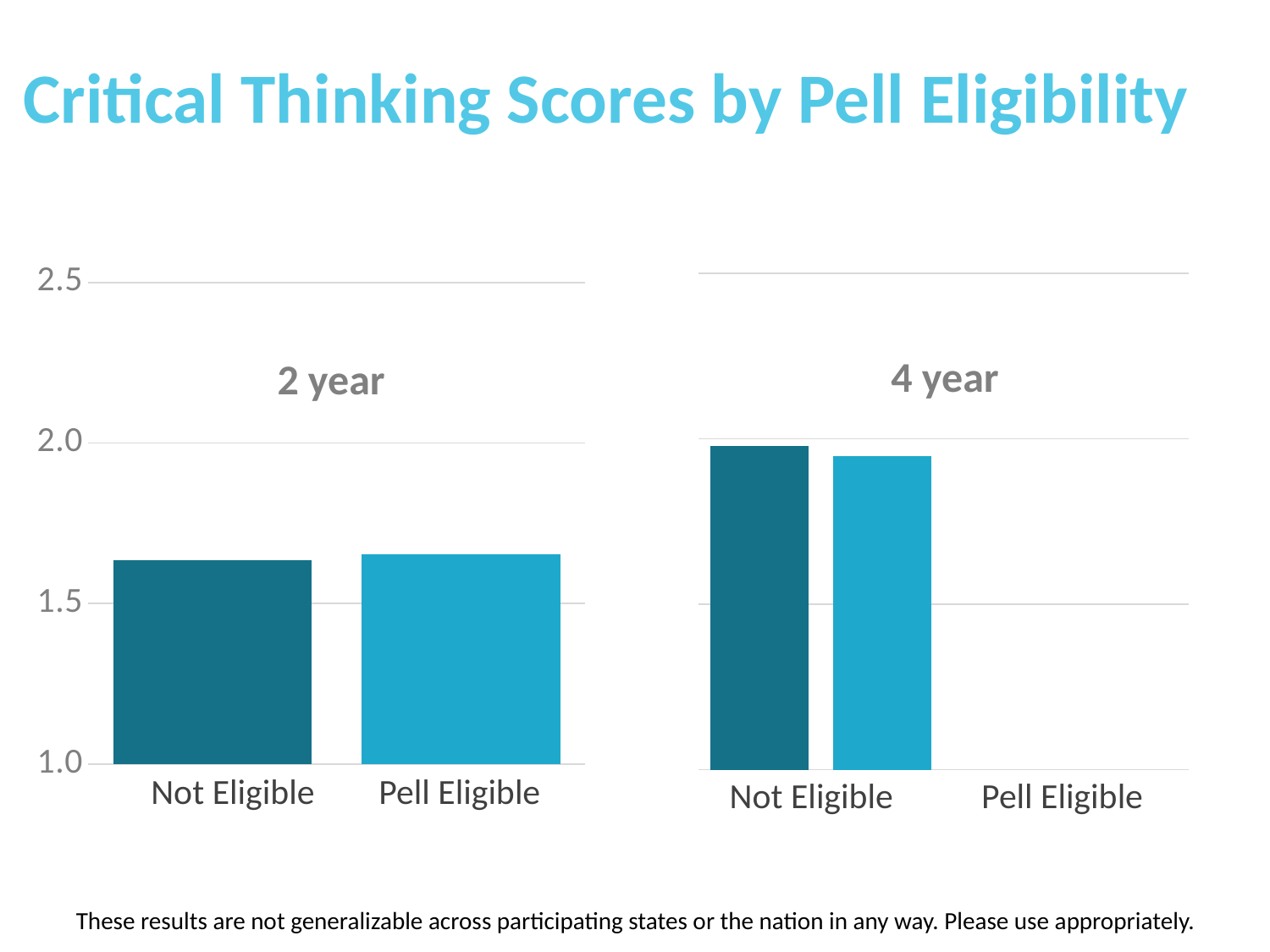
Which is larger: the Not Eligible value in the "4 year" chart or the Not Eligible value in the "2 year" chart? 4 year What kind of chart is the "2 year" chart? bar chart What kind of chart is the "4 year" chart? bar chart In the "2 year" chart, is the value for Pell Eligible greater or less than 2.0? less In the "2 year" chart, is the value for Not Eligible greater or less than 1.5? greater In the "2 year" chart, how many categories are shown on the x axis? 2 What is the highest value shown on the y axis of the "2 year" chart? 2.5 In the "4 year" chart, is the value for Not Eligible greater or less than 2.5? less In the "4 year" chart, how many categories are shown on the x axis? 2 What is the title of the slide? Critical Thinking Scores by Pell Eligibility